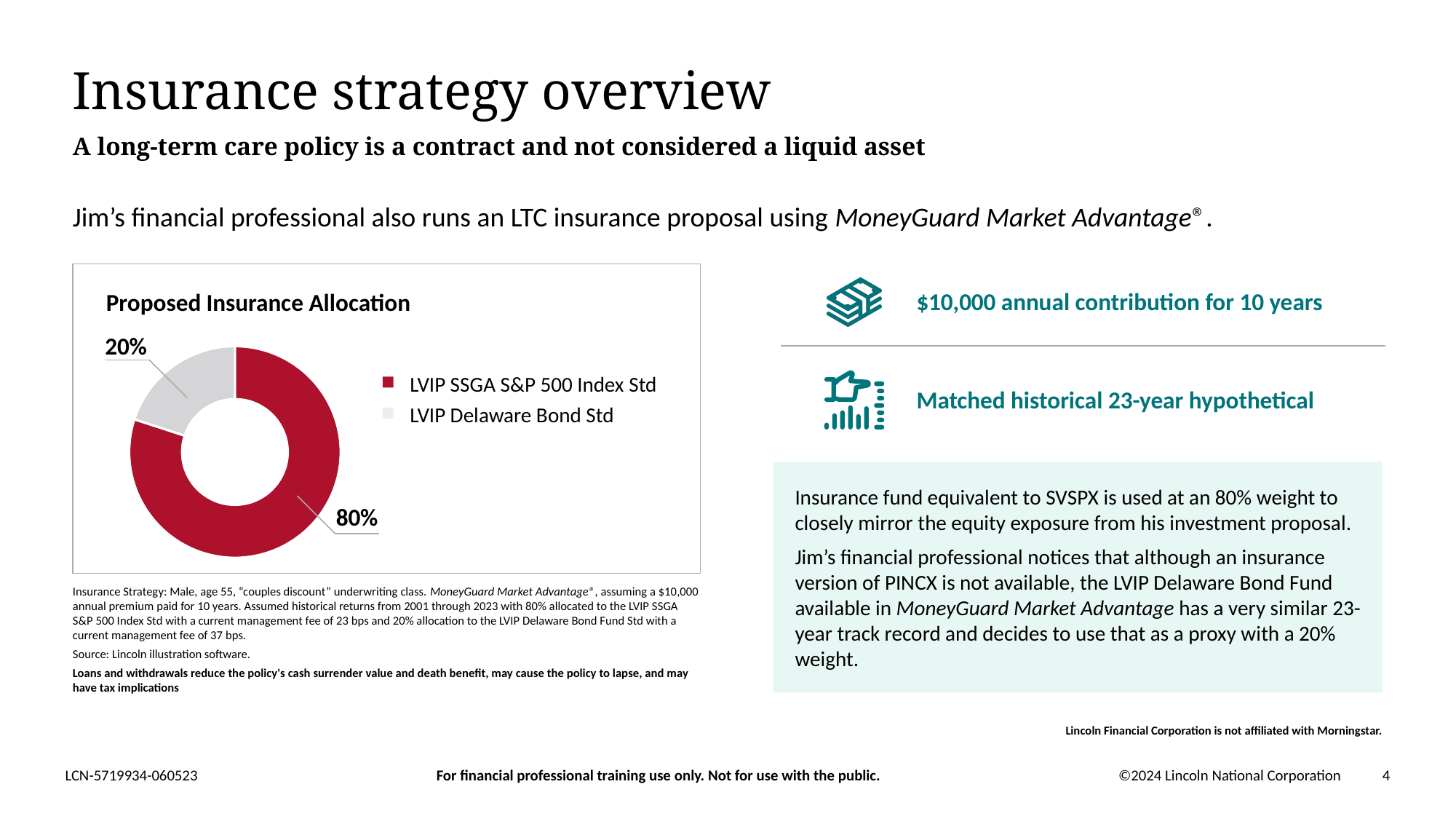
What share of the allocation is LVIP SSGA S&P 500 Index Std? 80% How many categories are shown in the chart? 2 What share of the allocation is LVIP Delaware Bond Std? 20% What colour represents LVIP SSGA S&P 500 Index Std in the chart? Red What is the title of the chart? Proposed Insurance Allocation What is the total of the two shares shown in the chart? 100% How many entries does the legend list? 2 Which category has the smallest share of the allocation? LVIP Delaware Bond Std What is the difference in percentage points between the LVIP SSGA S&P 500 Index Std share and the LVIP Delaware Bond Std share? 60 percentage points What kind of chart is shown on the slide? Pie chart (doughnut) Which category has the largest share of the allocation? LVIP SSGA S&P 500 Index Std Which is larger, the share for LVIP SSGA S&P 500 Index Std or the share for LVIP Delaware Bond Std? LVIP SSGA S&P 500 Index Std